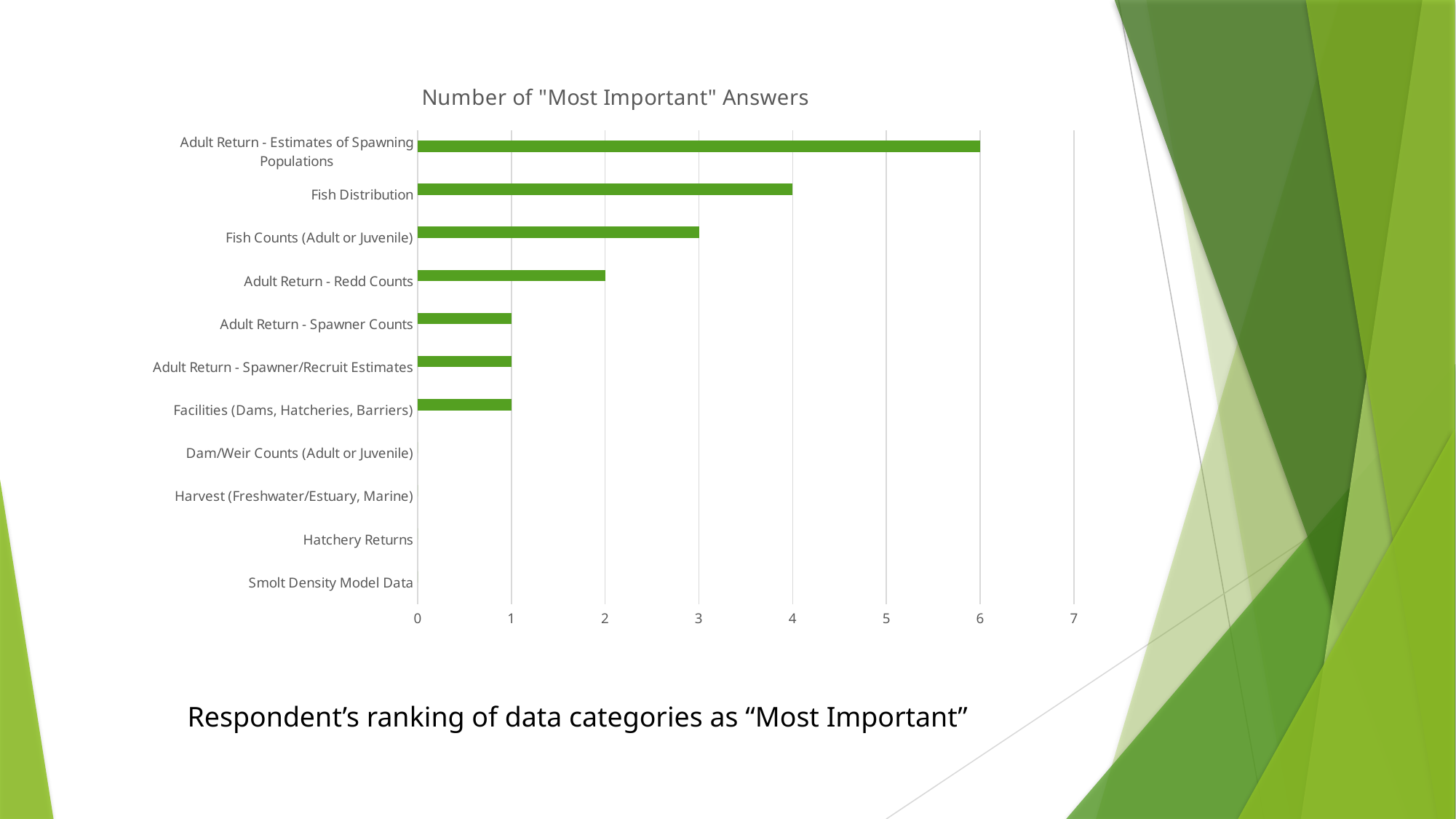
What is the difference between the number of answers for Adult Return - Estimates of Spawning Populations and Fish Distribution? 2 Is the value for Adult Return - Estimates of Spawning Populations greater or less than 5? greater Which received more "Most Important" answers, Fish Distribution or Fish Counts (Adult or Juvenile)? Fish Distribution What is the title of the chart? Number of "Most Important" Answers How many "Most Important" answers did Adult Return - Redd Counts receive? 2 How many "Most Important" answers did Fish Counts (Adult or Juvenile) receive? 3 How many "Most Important" answers did Adult Return - Estimates of Spawning Populations receive? 6 How many "Most Important" answers did Facilities (Dams, Hatcheries, Barriers) receive? 1 How many "Most Important" answers did Fish Distribution receive? 4 Which category received the most "Most Important" answers? Adult Return - Estimates of Spawning Populations What kind of chart is shown on the slide? bar chart How many data categories are listed on the chart? 11